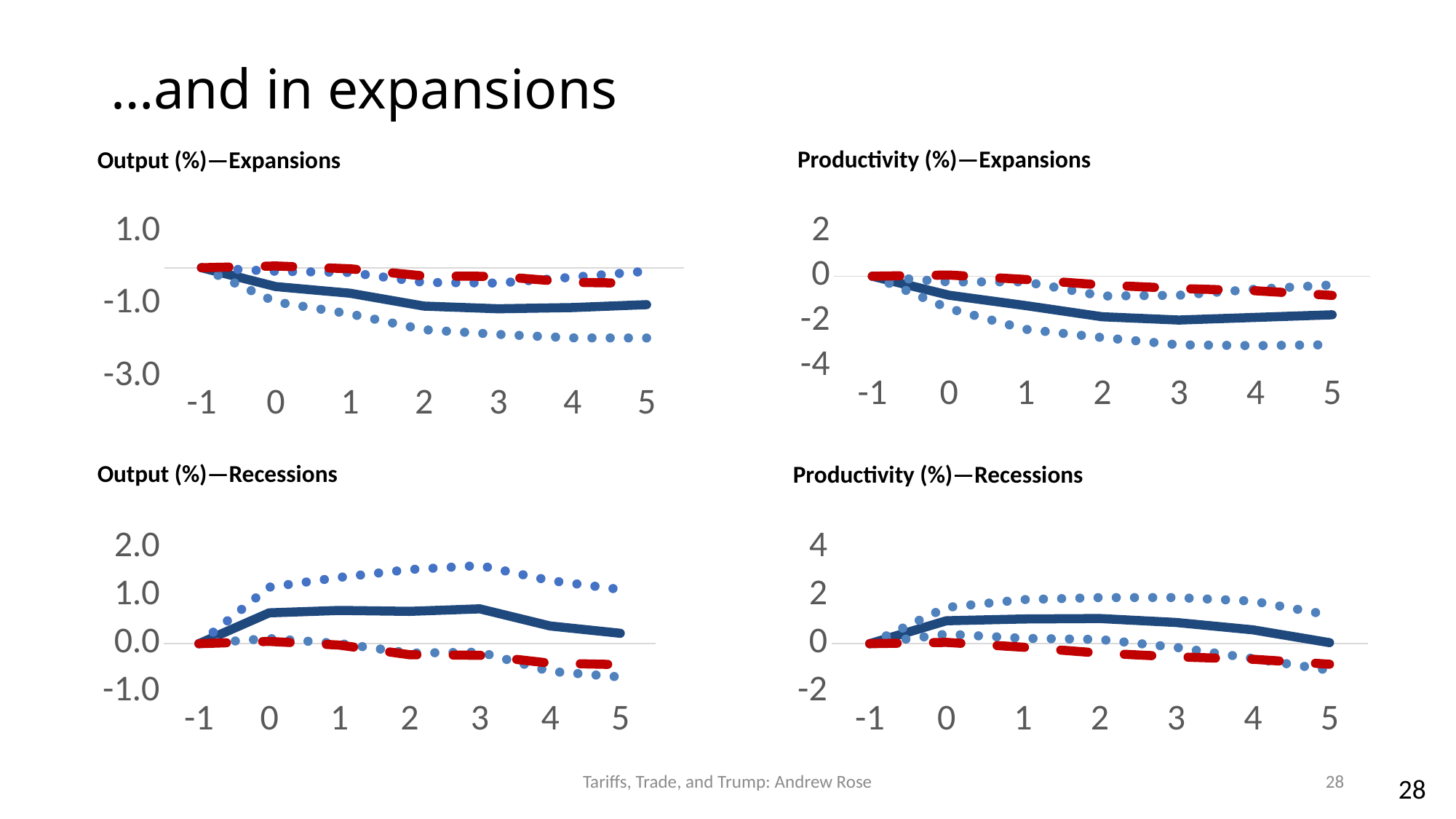
In the "Output (%)—Expansions" chart, does the solid line rise or fall from x = -1 to x = 5? fall In the "Productivity (%)—Expansions" chart, does the solid line rise or fall from x = -1 to x = 3? fall How many lines are plotted in the "Output (%)—Recessions" chart? 4 In the "Output (%)—Recessions" chart, is the value of the upper dotted line at x = 3 greater or less than 1.0? greater What is the title of the chart in the top-right position of the slide? Productivity (%)—Expansions In the "Productivity (%)—Recessions" chart, is the value of the lower dotted line at x = 5 greater or less than 0? less In the "Productivity (%)—Expansions" chart, is the value of the lower dotted line at x = 4 greater or less than -2? less How many charts are shown on the slide? 4 In the "Output (%)—Recessions" chart, at which x value does the solid line reach its highest point? 3 In the "Output (%)—Expansions" chart, at x = 5, is the solid line higher or lower than the red dashed line? lower What kind of chart is the "Output (%)—Expansions" chart? line chart In the "Productivity (%)—Recessions" chart, how many points are labelled on the x axis? 7